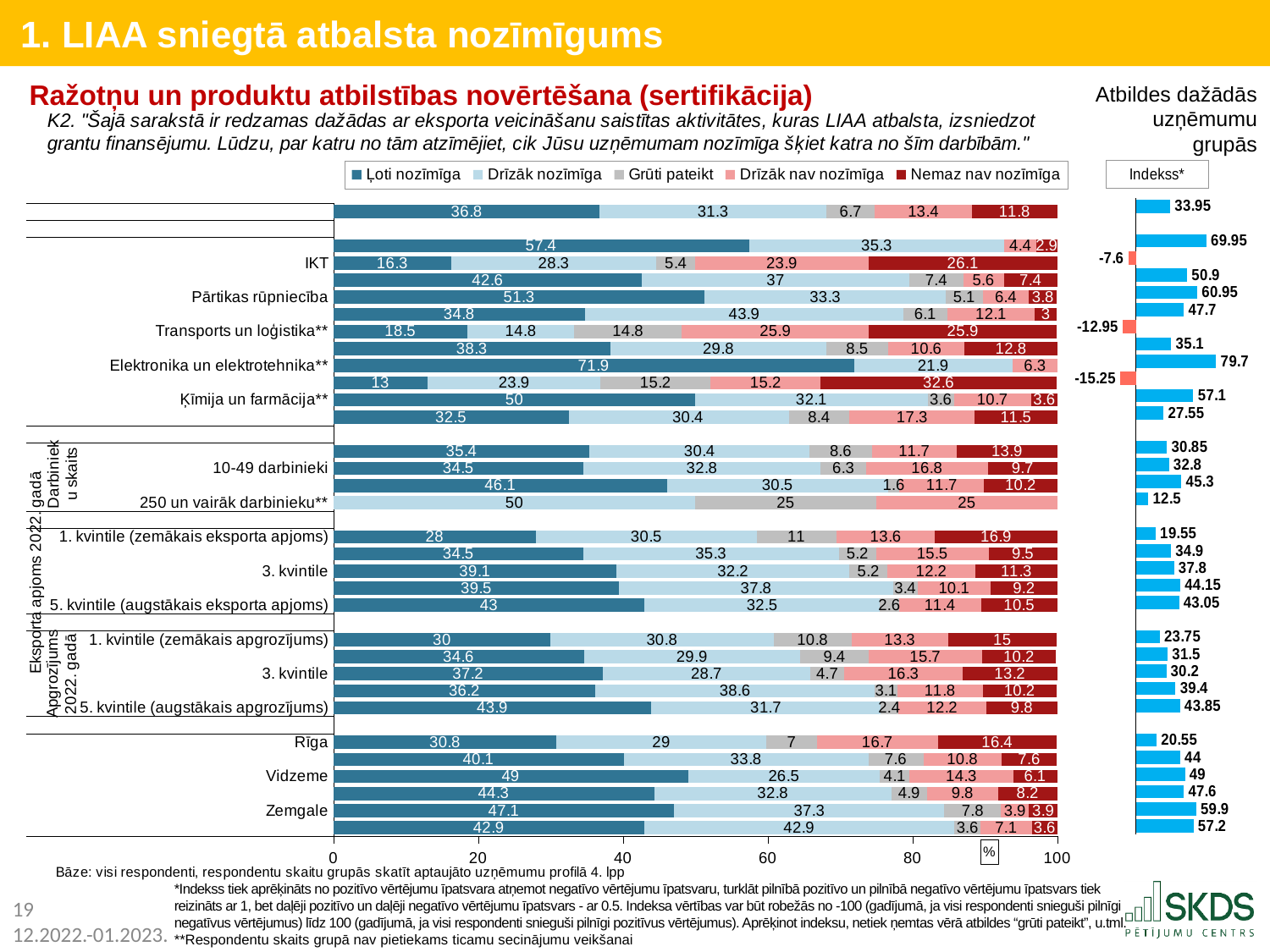
In the main chart, what is the difference between the 'Ļoti nozīmīga' values for Vidzeme (49) and Rīga (30.8)? 18.2 In the Indekss* chart, what is the index value for Elektronika un elektrotehnika**? 79.7 What is the title of the main chart on the slide? Ražotņu un produktu atbilstības novērtēšana (sertifikācija) In the Indekss* chart, what is the index value for Transports un loģistika**? -12.95 What kind of chart is used to show the distribution of answers on this slide? bar chart In the main chart, what is the 'Nemaz nav nozīmīga' value for IKT? 26.1 In the main chart, what is the 'Ļoti nozīmīga' value for Pārtikas rūpniecība? 51.3 In the main chart, which of Rīga or Vidzeme has the larger 'Ļoti nozīmīga' value? Vidzeme How many series does the legend of the main chart list? 5 In the Indekss* chart, what is the index value for 1. kvintile (zemākais eksporta apjoms)? 19.55 In the main chart, what is the 'Ļoti nozīmīga' value for Elektronika un elektrotehnika**? 71.9 In the main chart, what is the 'Drīzāk nozīmīga' value for Zemgale? 37.3